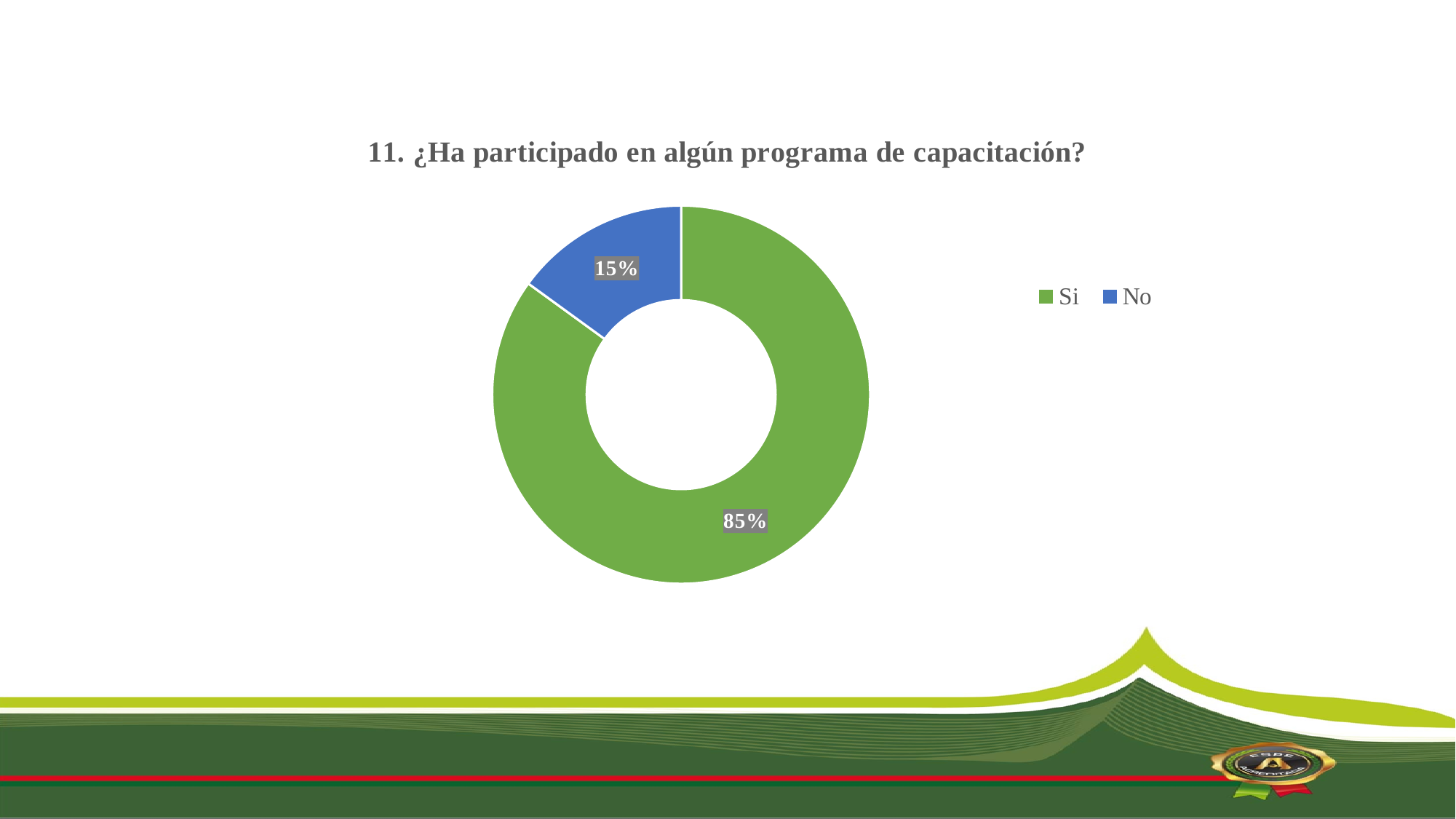
Which is larger, the share for "Si" or the share for "No"? Si What share of the chart does the "Si" slice represent? 85% Which category has the largest share of the chart? Si What kind of chart is shown on the slide? Doughnut chart Which category has the smallest share of the chart? No How many entries does the legend list? 2 What is the difference in percentage points between the "Si" and "No" shares? 70 How many categories does the chart show? 2 What is the title of the chart? 11. ¿Ha participado en algún programa de capacitación? What colour represents the "No" category? Blue What percentage of respondents answered "No"? 15% What percentage of respondents answered "Si"? 85%